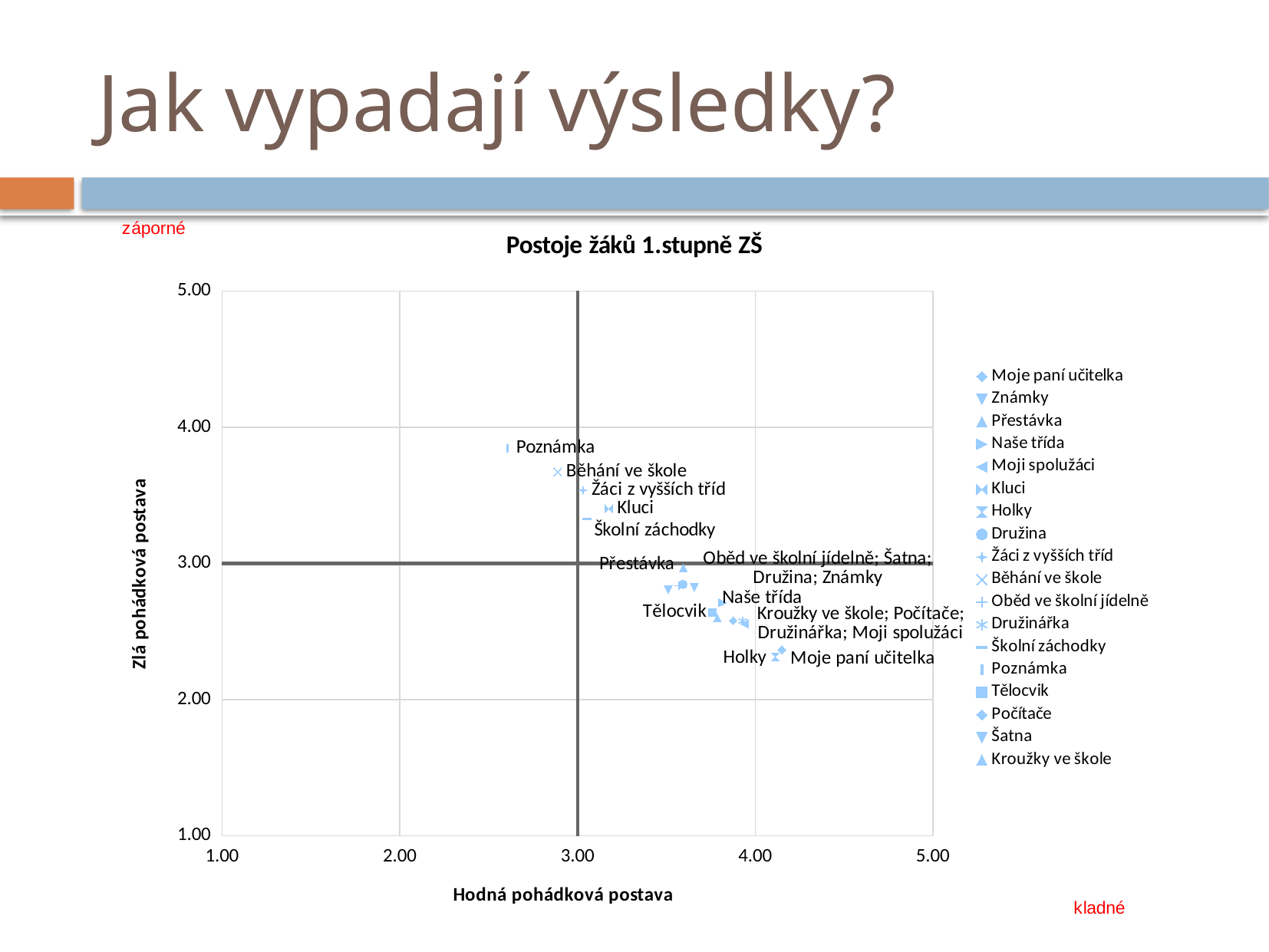
Is the horizontal-axis value for Běhání ve škole greater or less than 3.00? less Which series has the lowest value on the horizontal axis (Hodná pohádková postava)? Poznámka What is the title of the horizontal axis? Hodná pohádková postava How many series does the chart legend list? 18 Is the vertical-axis value for Tělocvik greater or less than 3.00? less Which has the higher vertical-axis value, Poznámka or Holky? Poznámka Which series has the highest value on the vertical axis (Zlá pohádková postava)? Poznámka What kind of chart is shown on the slide? scatter chart What is the title of the chart? Postoje žáků 1.stupně ZŠ Is the horizontal-axis value for Moje paní učitelka greater or less than 4.00? greater Which has the larger horizontal-axis value, Běhání ve škole or Kluci? Kluci